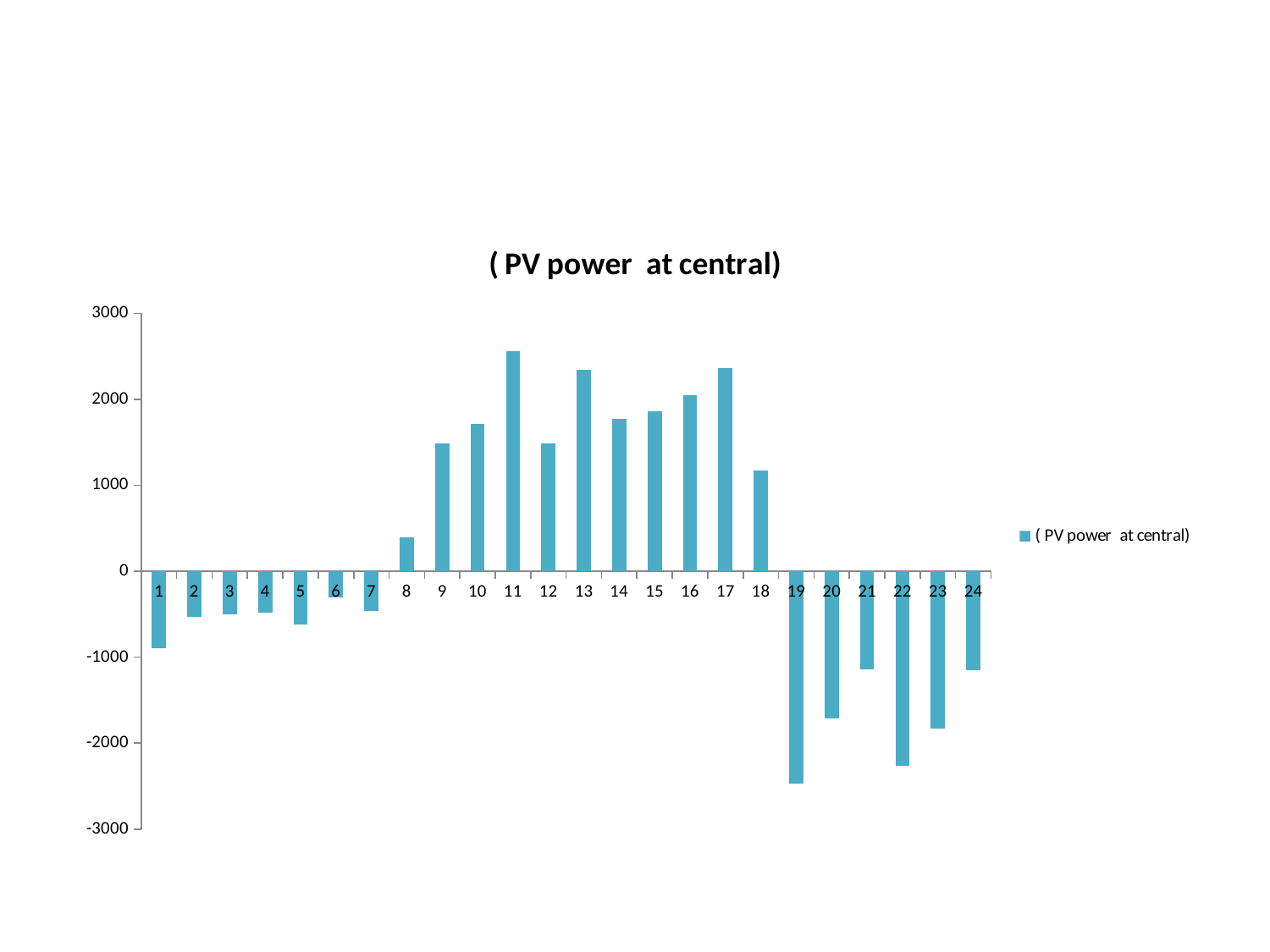
Do the values rise or fall from category 8 to category 11? rise Which category has the lowest value? 19 Which category has the highest value? 11 How many series does the legend list? 1 What is the title of the chart? ( PV power at central) Is the value for category 10 greater or less than 1000? greater Is the value for category 19 greater or less than -2000? less Which has the larger value, category 13 or category 14? 13 How many categories are plotted along the x axis? 24 Is the value for category 8 greater or less than 1000? less What kind of chart is shown on the slide? bar chart